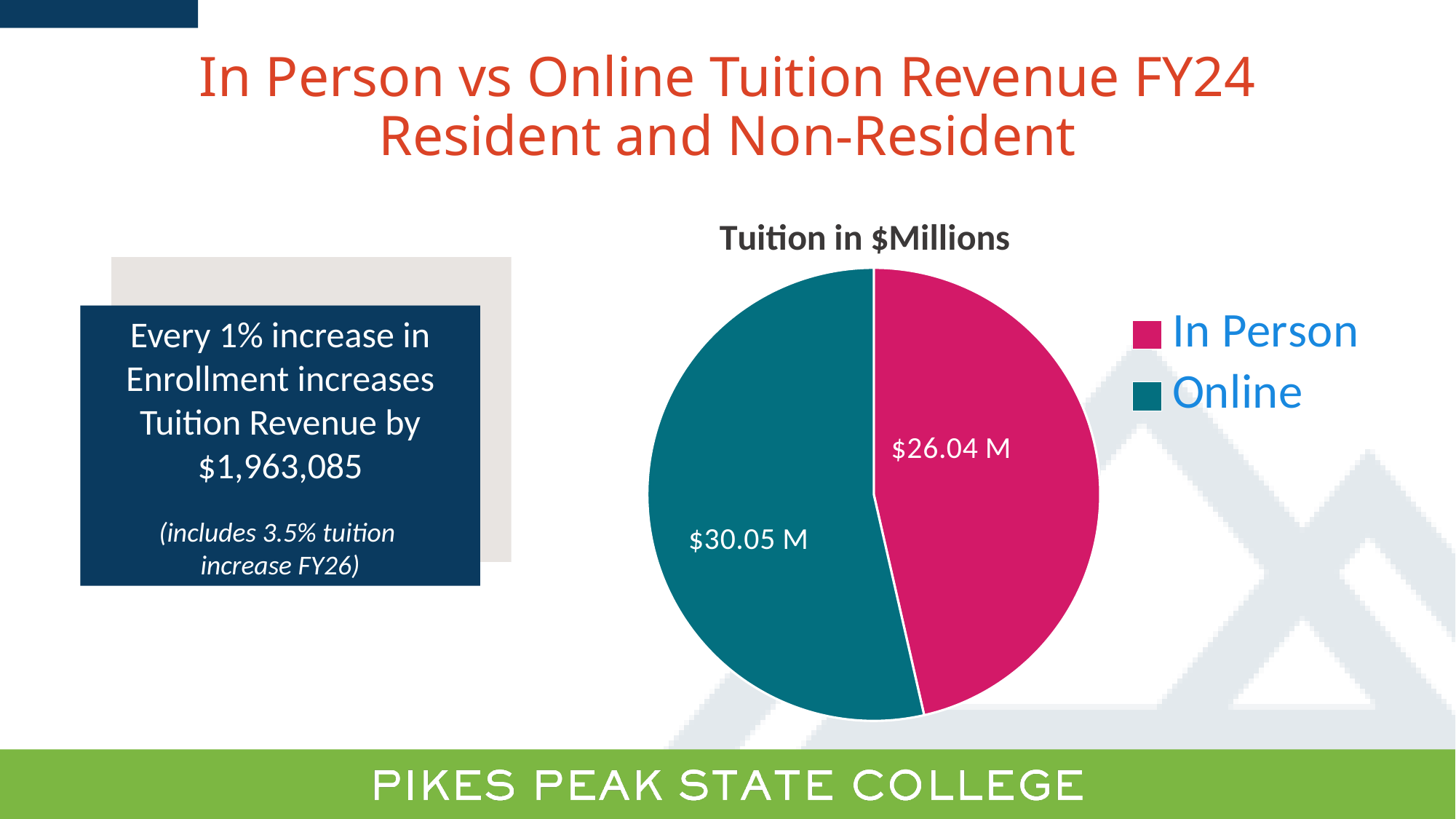
What is the title of the chart? Tuition in $Millions What is the tuition revenue value for In Person? $26.04 M Which is larger, the In Person value or the Online value? Online What is the difference between the Online and In Person values? $4.01 M What colour represents Online in the pie chart? teal What is the total of the two slices in the pie chart? $56.09 M What is the tuition revenue value for Online? $30.05 M What type of chart is shown on the slide? pie chart Which category has the smaller slice of the pie? In Person How many slices does the pie chart have? 2 Which category has the larger slice of the pie? Online How many entries does the legend list? 2